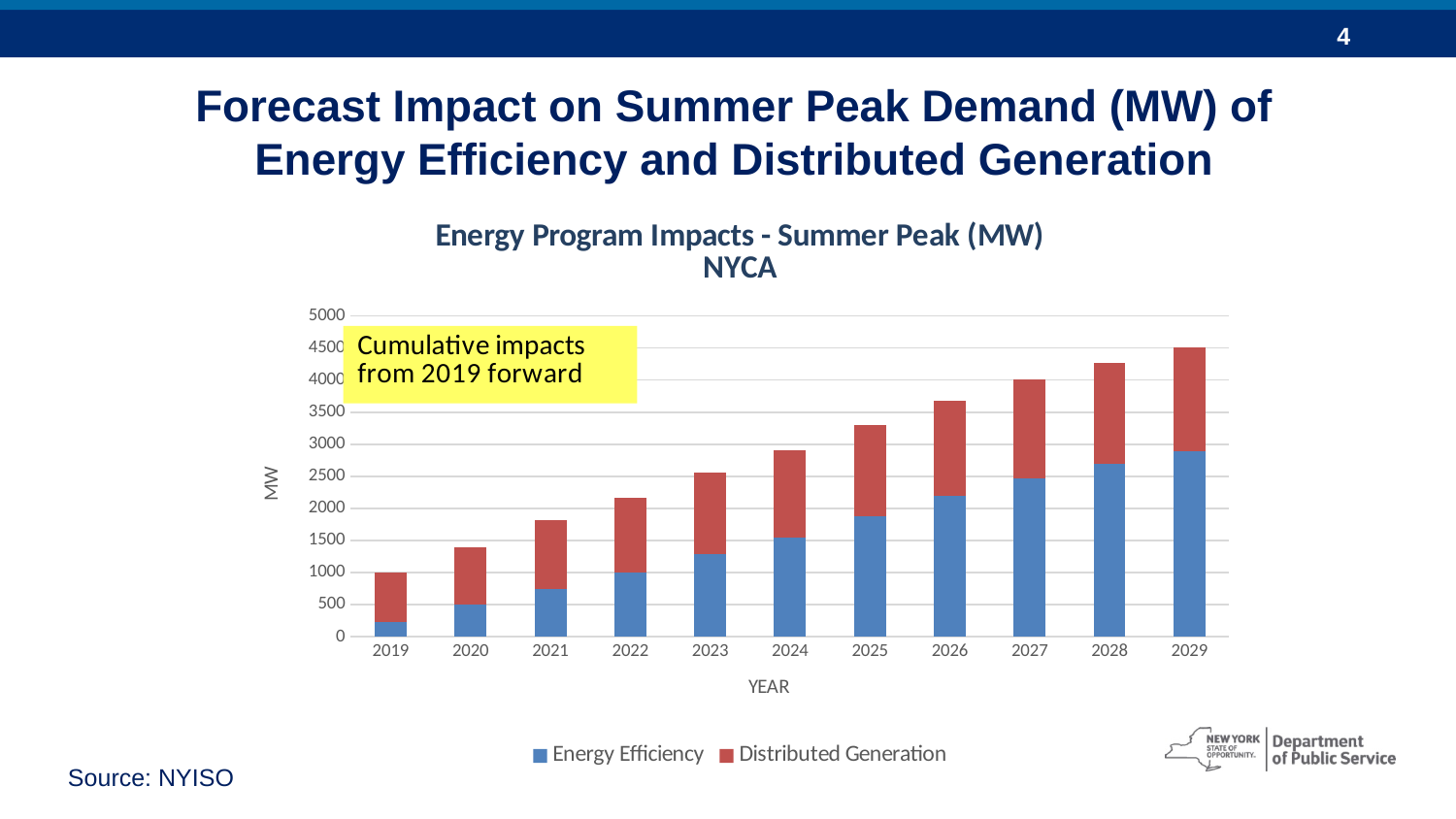
Which year has the lowest total stacked bar? 2019 Do the total stacked values rise or fall from 2019 to 2029? Rise How many series does the chart's legend list? 2 Which series is shown in red in the chart? Distributed Generation Is the total stacked value for 2019 greater or less than 1500? less Which is larger: the Energy Efficiency value for 2029 or the total stacked value for 2019? Energy Efficiency value for 2029 Is the Energy Efficiency value for 2028 greater or less than 2500? greater Which year has the highest total stacked bar? 2029 How many years are shown on the x axis of the chart? 11 Is the total stacked value for 2029 greater or less than 4000? greater What kind of chart is shown on the slide? Stacked bar chart